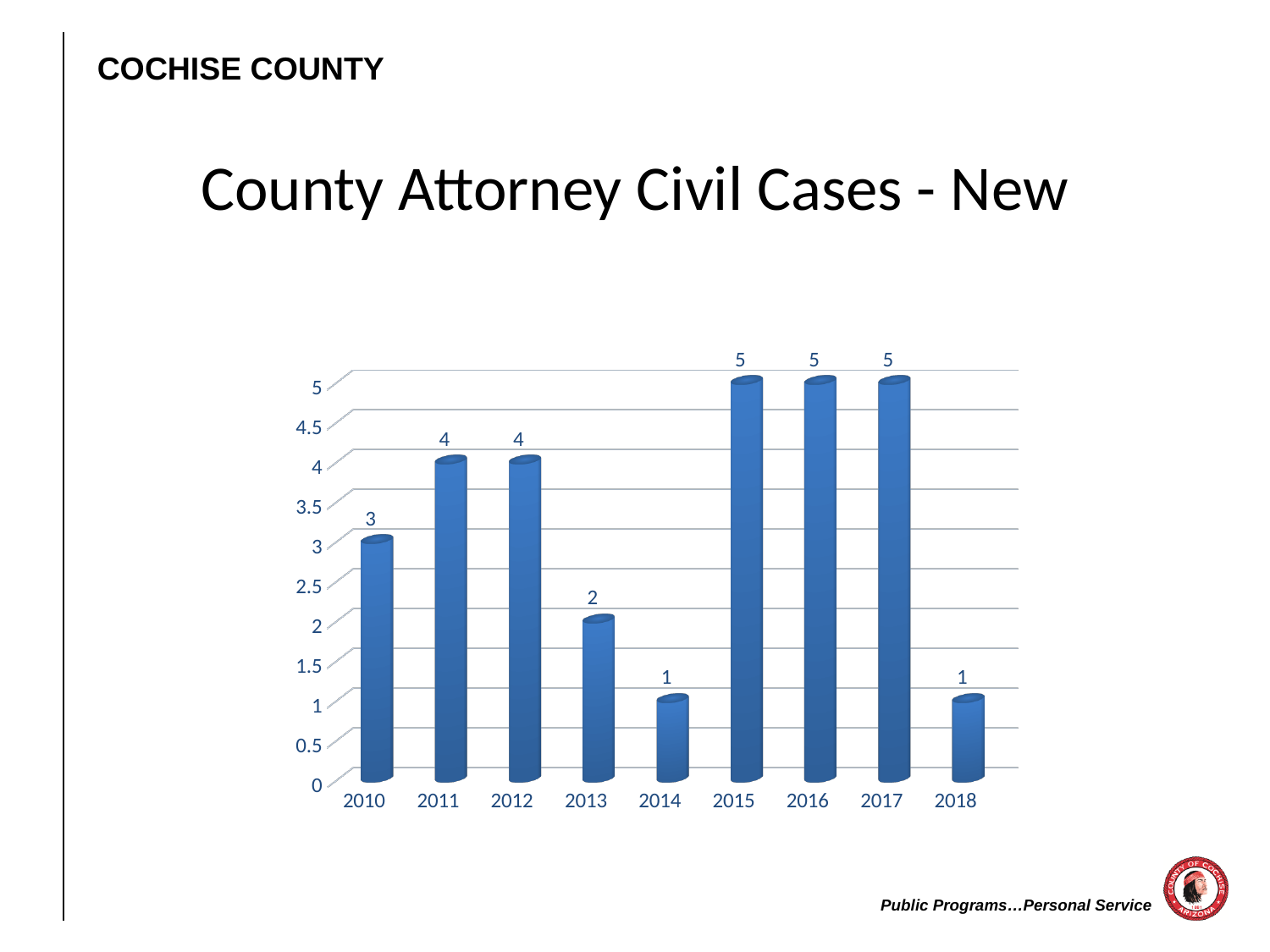
Do the values rise or fall from 2012 to 2014? fall What is the difference between the values for 2015 and 2014? 4 What is the title of the chart? County Attorney Civil Cases - New How many years are shown on the x axis? 9 What is the value for 2010? 3 What is the value for 2018? 1 What is the value for 2013? 2 What kind of chart is shown? bar chart What is the value for 2016? 5 Which years have the highest value? 2015, 2016, 2017 Which years have the lowest value? 2014, 2018 Which is larger, the value for 2011 or the value for 2013? 2011